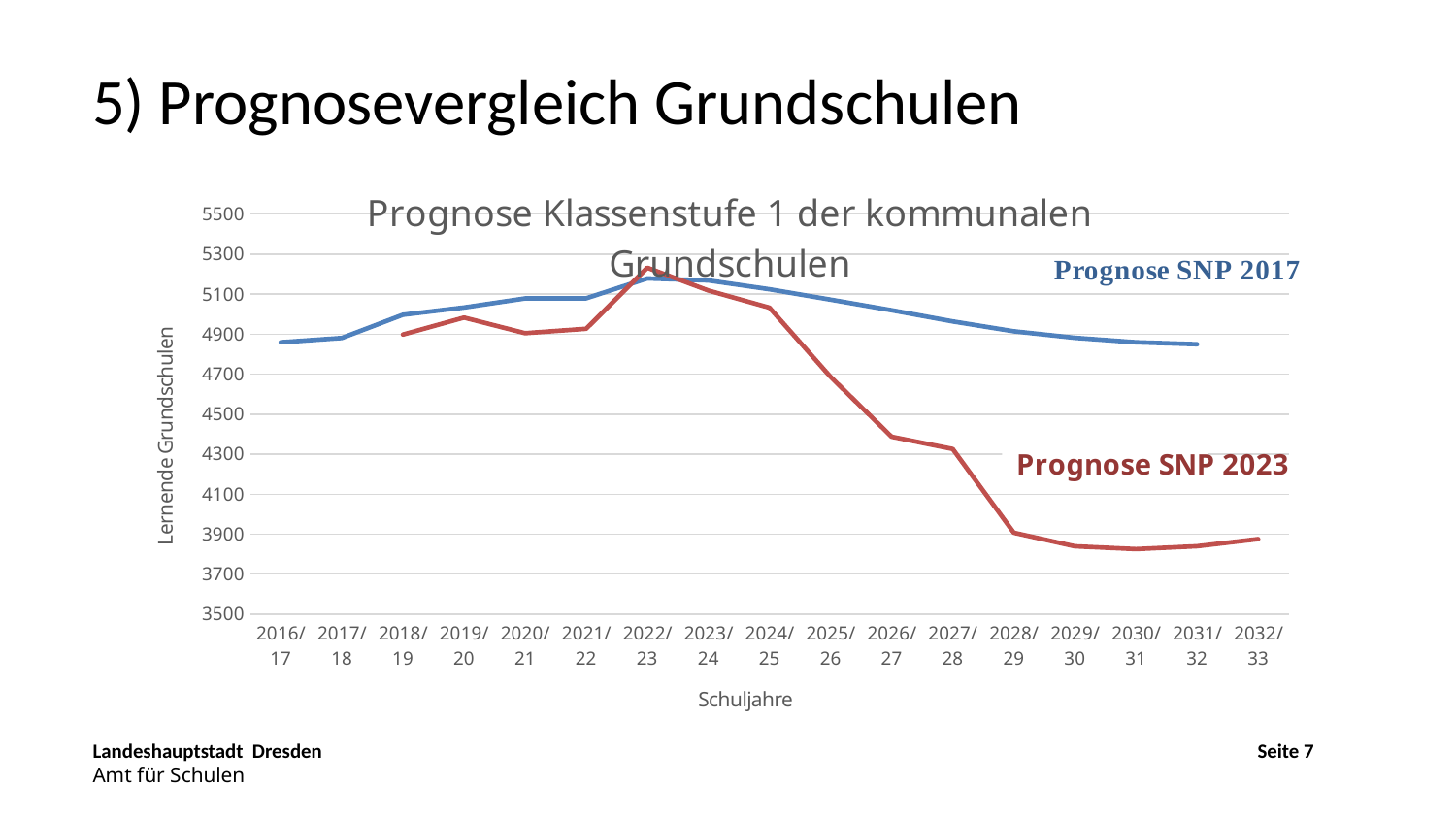
What is the title of the chart? Prognose Klassenstufe 1 der kommunalen Grundschulen What kind of chart is shown on the slide? Line chart Is the value for Prognose SNP 2023 in 2022/23 greater or less than 5100? greater How many series are plotted in the chart? 2 In 2028/29, which series has the higher value, Prognose SNP 2017 or Prognose SNP 2023? Prognose SNP 2017 In which school year does the Prognose SNP 2023 series reach its highest value? 2022/23 Which series is drawn in red? Prognose SNP 2023 Is the value for Prognose SNP 2023 in 2032/33 greater or less than 4100? less How many school years (Schuljahre) are shown on the x axis? 17 Is the value for Prognose SNP 2023 in 2026/27 greater or less than 4500? less Does the Prognose SNP 2023 line rise or fall between 2024/25 and 2029/30? Fall